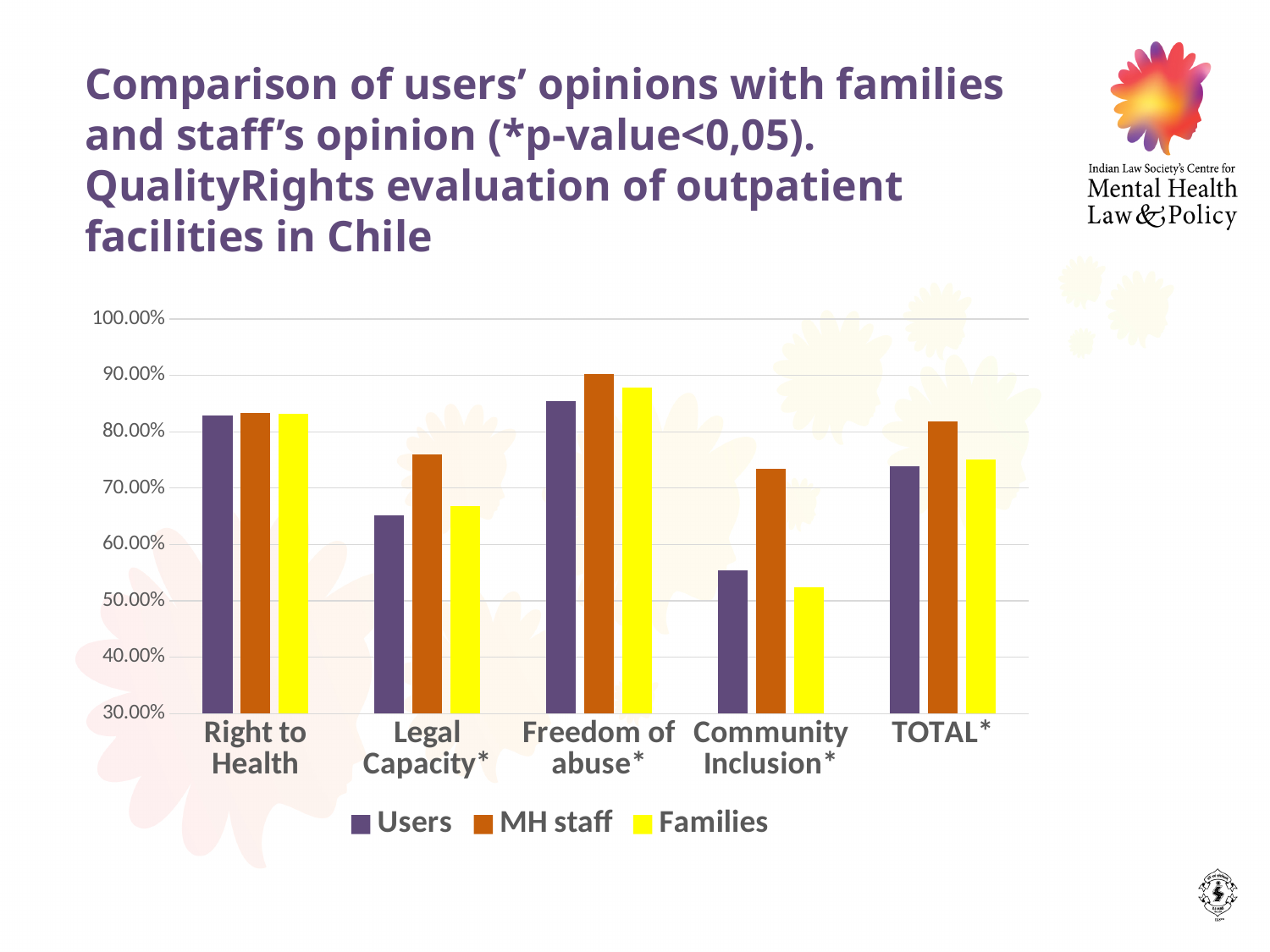
Is the Users value for Community Inclusion* greater or less than 60.00%? less For Community Inclusion*, which is larger: the MH staff value or the Families value? MH staff For which category is the Families value the lowest? Community Inclusion* How many categories are shown on the x axis of the chart? 5 Is the MH staff value for Legal Capacity* greater or less than 70.00%? greater For Legal Capacity*, which is larger: the Users value or the MH staff value? MH staff For which category is the Users value the lowest? Community Inclusion* For which category is the MH staff value the highest? Freedom of abuse* What kind of chart is shown on the slide? bar chart How many series does the chart's legend list? 3 Which series are listed in the chart's legend? Users, MH staff, Families Is the Families value for Freedom of abuse* greater or less than 80.00%? greater